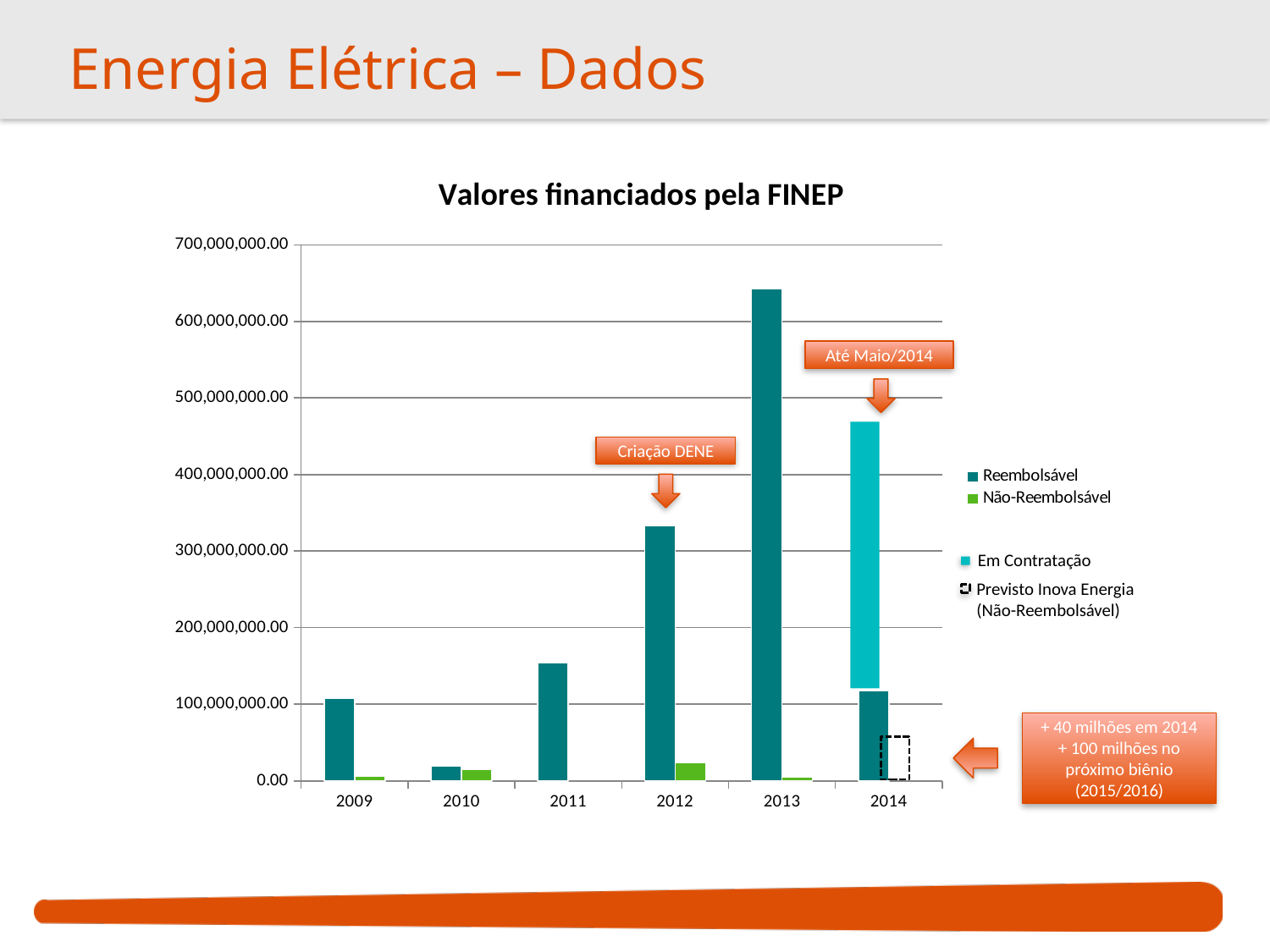
Is the Reembolsável value for 2012 greater or less than 300,000,000.00? greater Does the Reembolsável value rise or fall from 2010 to 2013? rise Which year has the lowest Reembolsável value? 2010 Is the Reembolsável value for 2011 greater or less than 200,000,000.00? less Is the Reembolsável value for 2013 greater or less than 600,000,000.00? greater Which series in the legend is shown with a dashed outline? Previsto Inova Energia (Não-Reembolsável) What kind of chart is shown on the slide? bar chart What is the title of the chart? Valores financiados pela FINEP Which year has the larger Reembolsável value, 2011 or 2012? 2012 Which year has the highest Reembolsável value? 2013 How many years are shown on the x axis of the chart? 6 How many series does the chart legend list? 4